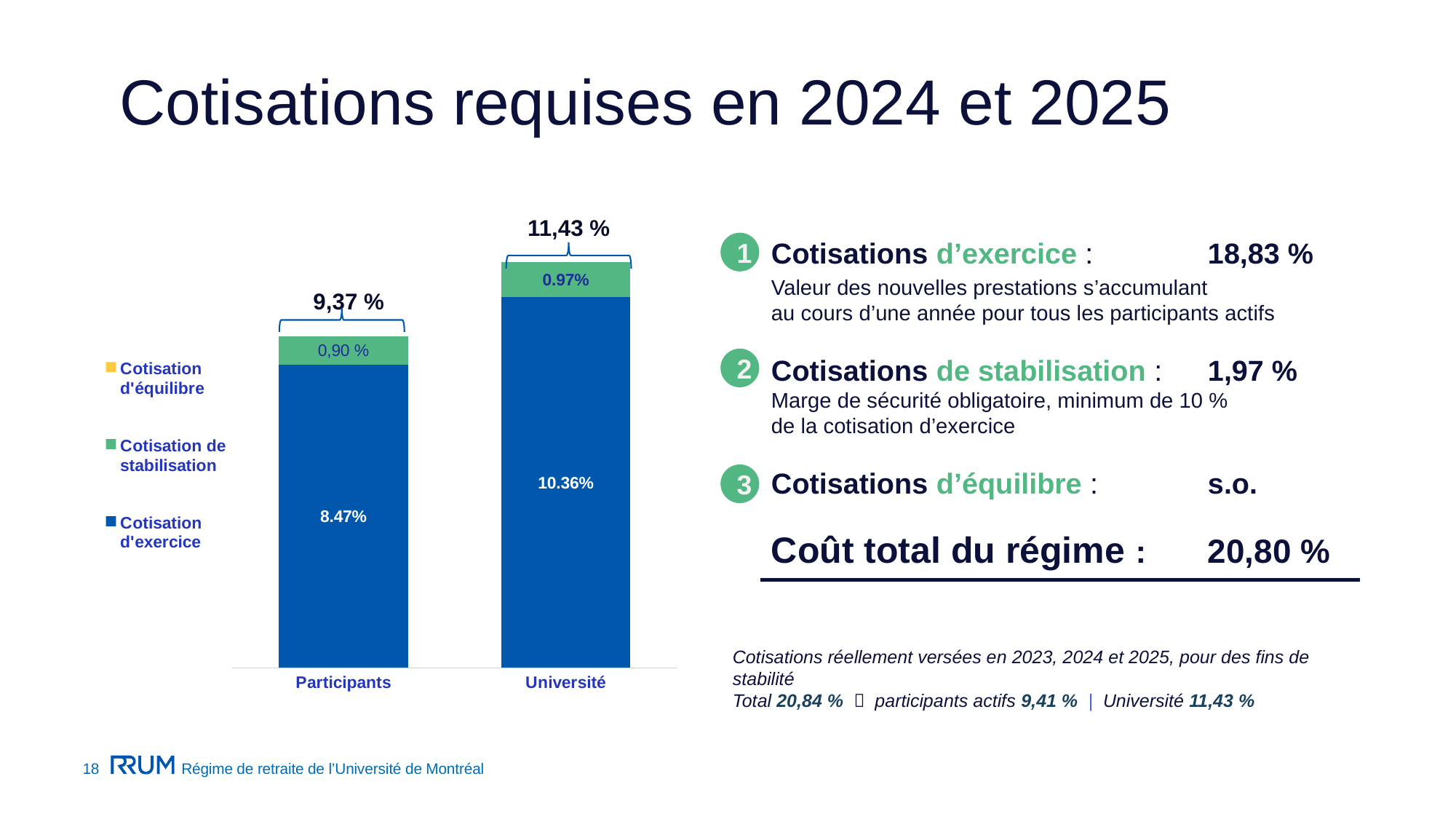
What kind of chart is shown on the slide? Stacked bar chart Which category has the higher total contribution, Participants or Université? Université What is the total of the stacked bar for Participants? 9,37 % What is the Cotisation de stabilisation value for Université? 0.97% How many categories are shown on the x axis of the chart? 2 What is the total of the stacked bar for Université? 11,43 % What is the Cotisation d'exercice value for Université? 10.36% What is the Cotisation de stabilisation value for Participants? 0,90 % What is the difference between the Cotisation d'exercice for Université and for Participants? 1.89% What is the difference between the total for Université and the total for Participants? 2,06 % How many series does the chart legend list? 3 What is the Cotisation d'exercice value for Participants? 8.47%